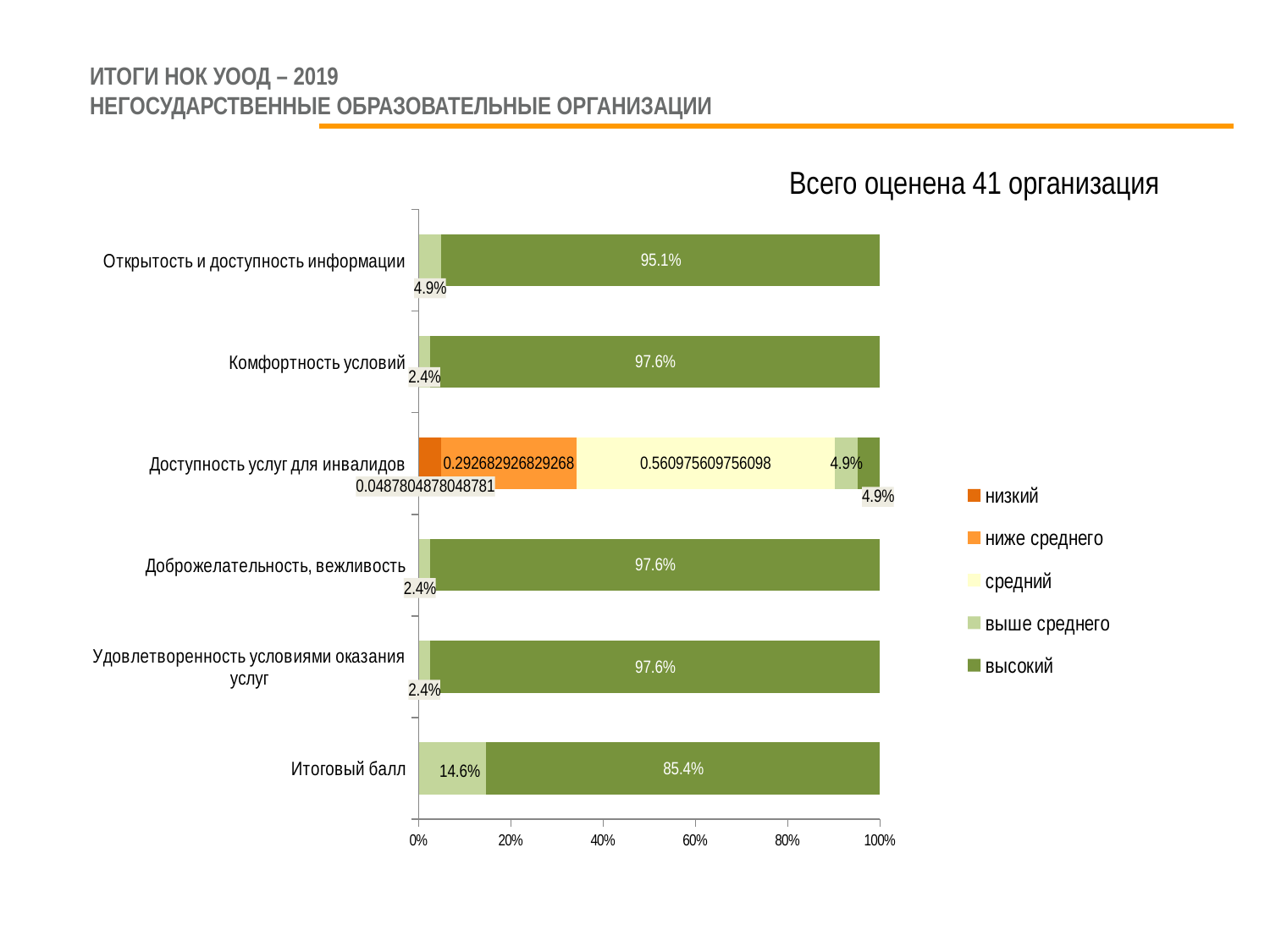
What is the value of the «выше среднего» series for «Итоговый балл»? 14.6% How many categories are shown on the chart? 6 Which category has the lowest value for the «высокий» series? Доступность услуг для инвалидов Is the «средний» value for «Доступность услуг для инвалидов» greater or less than 40%? greater What is the value of the «высокий» series for «Комфортность условий»? 97.6% Which has the larger «выше среднего» value: «Итоговый балл» or «Открытость и доступность информации»? Итоговый балл What is the value of the «средний» series for «Доступность услуг для инвалидов»? 0.560975609756098 How many series does the legend list? 5 What kind of chart is shown on the slide? Stacked bar chart What is the value of the «ниже среднего» series for «Доступность услуг для инвалидов»? 0.292682926829268 What is the difference between the «высокий» value for «Открытость и доступность информации» and the «высокий» value for «Итоговый балл»? 9.7% What is the value of the «высокий» series for «Открытость и доступность информации»? 95.1%